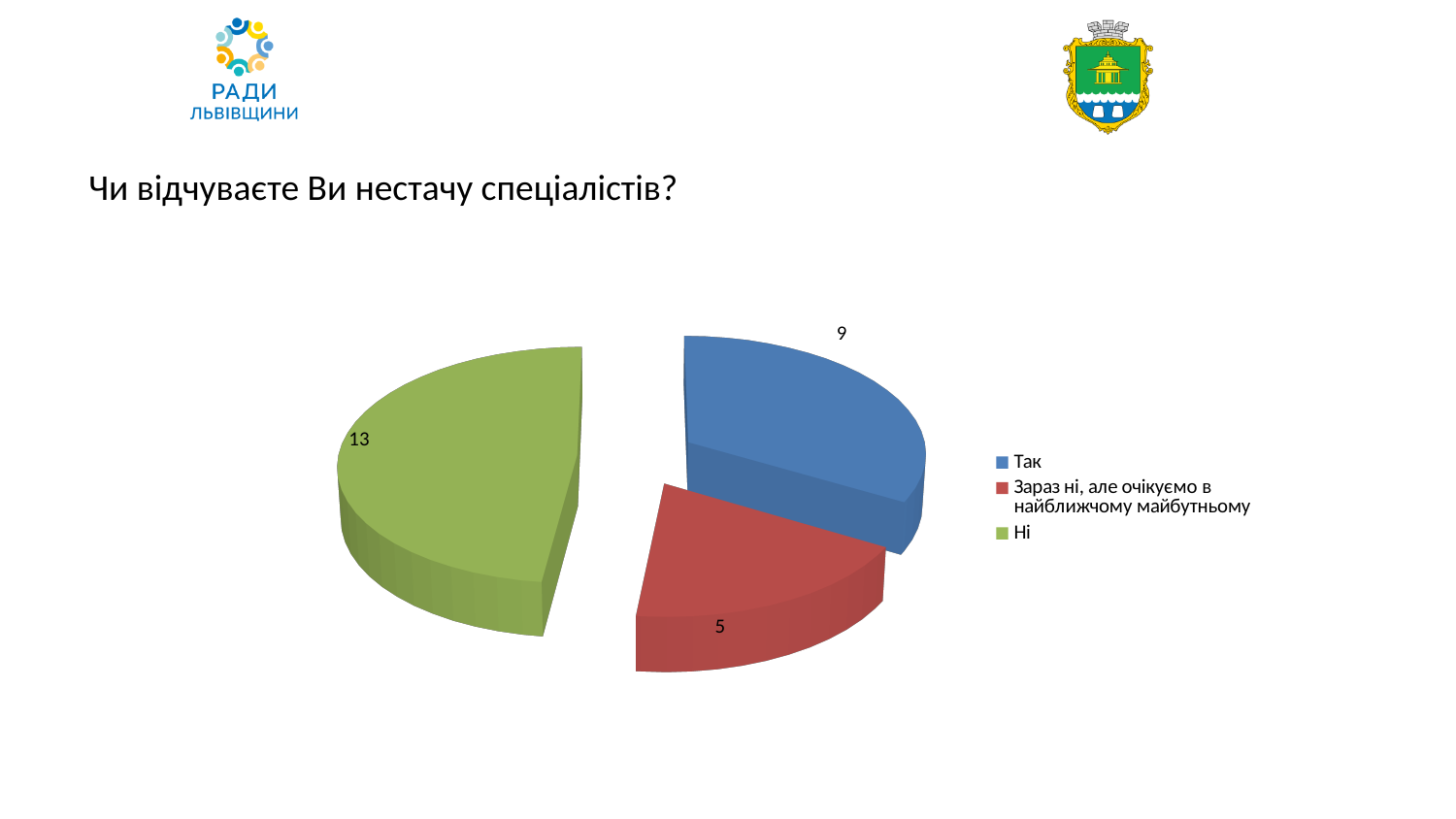
What kind of chart is shown on the slide? Pie chart What is the value for "Зараз ні, але очікуємо в найближчому майбутньому" in the pie chart? 5 What colour is the "Ні" slice in the pie chart? Green Which category has the largest slice in the pie chart? Ні How many slices does the pie chart have? 3 What share of the pie does the "Так" slice represent? 33.3% What is the value for "Так" in the pie chart? 9 What is the value for "Ні" in the pie chart? 13 What is the difference between the values for "Ні" and "Так"? 4 Which category has the smallest slice in the pie chart? Зараз ні, але очікуємо в найближчому майбутньому Which is larger: the value for "Так" or the value for "Зараз ні, але очікуємо в найближчому майбутньому"? Так What is the total of all values in the pie chart? 27